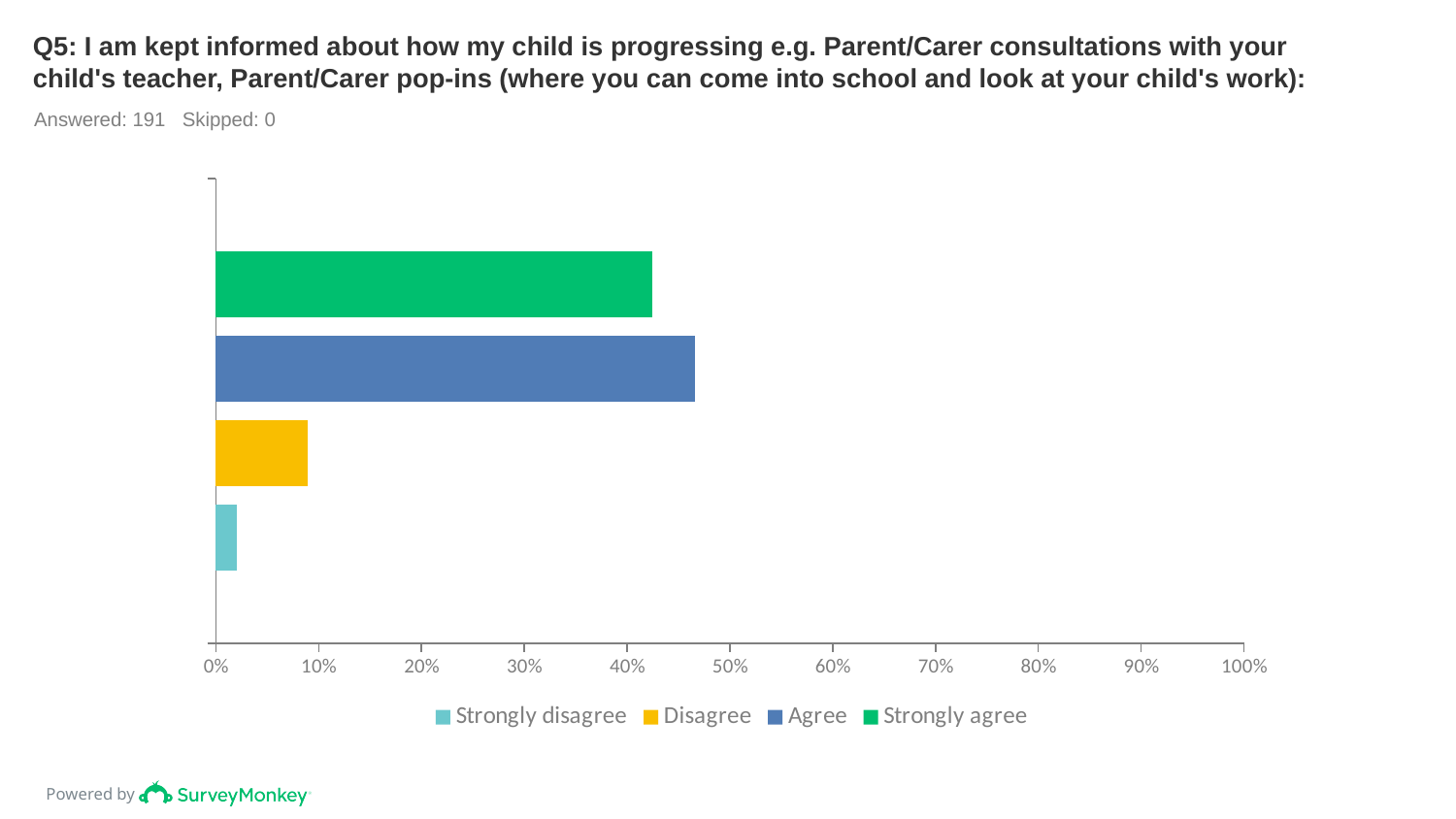
What kind of chart is shown on the slide? bar chart Which response has the shortest bar? Strongly disagree How many respondents answered this question according to the slide? 191 How many series does the legend list? 4 Is the value for Strongly disagree greater or less than 10%? less Which response has the longest bar? Agree Which is larger, the value for Disagree or the value for Strongly disagree? Disagree Is the value for Agree greater or less than 40%? greater Is the value for Disagree greater or less than 20%? less How many bars are plotted in the chart? 4 Which is larger, the value for Agree or the value for Strongly agree? Agree